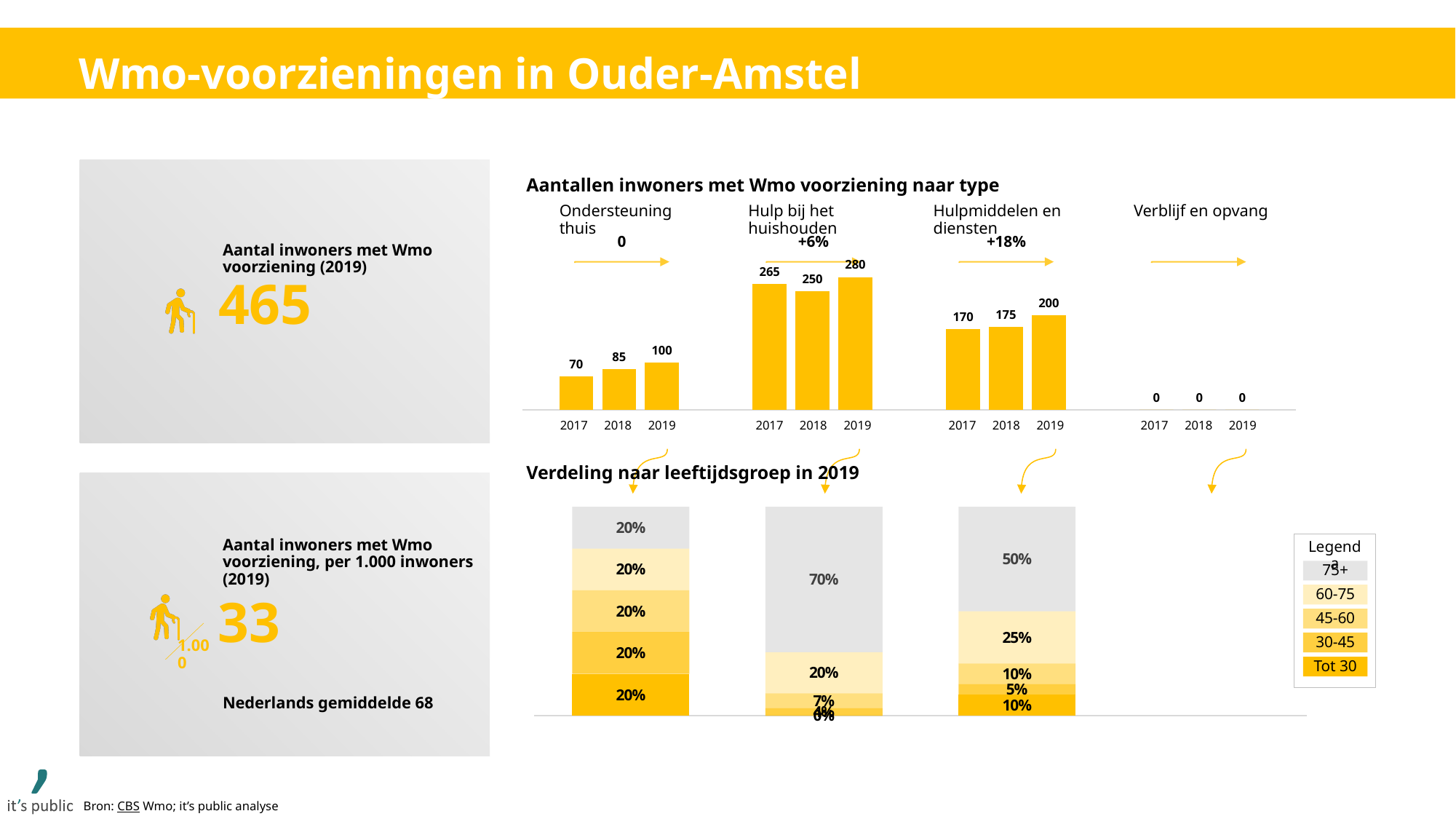
In the chart 'Aantallen inwoners met Wmo voorziening naar type', what is the value for Hulp bij het huishouden in 2019? 280 What kind of chart is 'Aantallen inwoners met Wmo voorziening naar type'? bar chart In the chart 'Verdeling naar leeftijdsgroep in 2019', what share of the Hulp bij het huishouden bar is the 75+ age group? 70% How many age groups does the legend of the chart 'Verdeling naar leeftijdsgroep in 2019' list? 5 In the chart 'Aantallen inwoners met Wmo voorziening naar type', what is the value for Hulpmiddelen en diensten in 2017? 170 In the chart 'Aantallen inwoners met Wmo voorziening naar type', what is the value for Verblijf en opvang in 2019? 0 In the chart 'Aantallen inwoners met Wmo voorziening naar type', which year has the highest value for Ondersteuning thuis? 2019 In the chart 'Verdeling naar leeftijdsgroep in 2019', what share of the Hulpmiddelen en diensten bar is the 75+ age group? 50% In the chart 'Aantallen inwoners met Wmo voorziening naar type', what is the difference between the 2019 and 2017 values for Ondersteuning thuis? 30 In the chart 'Aantallen inwoners met Wmo voorziening naar type', what percentage change is shown above the Hulpmiddelen en diensten bars? +18% In the chart 'Aantallen inwoners met Wmo voorziening naar type', do the values for Ondersteuning thuis rise or fall from 2017 to 2019? rise In the chart 'Aantallen inwoners met Wmo voorziening naar type', which is larger: Hulp bij het huishouden in 2018 or Hulpmiddelen en diensten in 2019? Hulp bij het huishouden in 2018